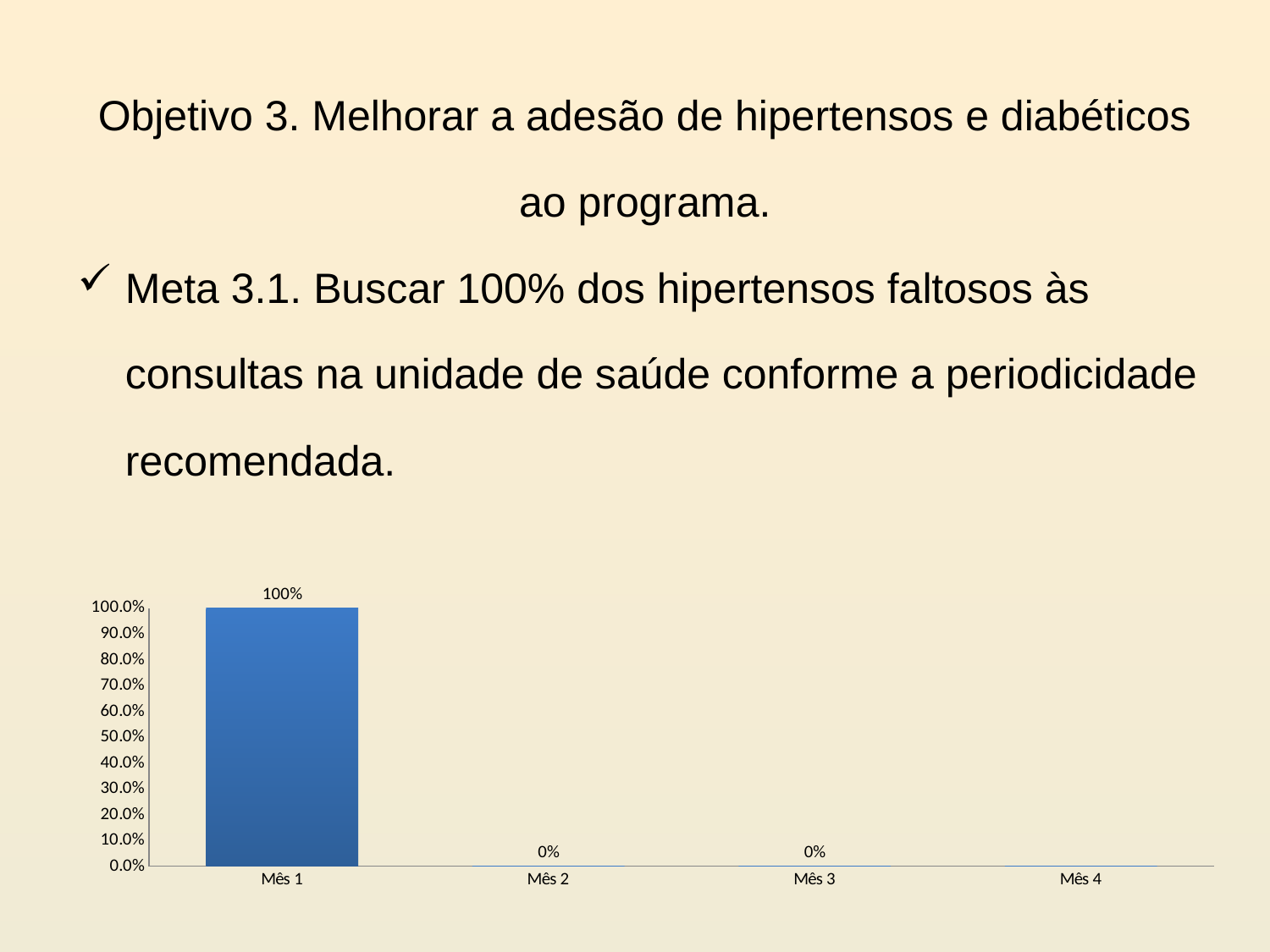
What is the highest tick label on the y axis? 100.0% Is the value for Mês 1 greater or less than 50.0%? greater What is the difference between the values for Mês 1 and Mês 2? 100% How many categories are shown on the x axis? 4 What is the value for Mês 2? 0% What is the value for Mês 3? 0% Which month has the highest value? Mês 1 Do the values rise or fall from Mês 1 to Mês 3? fall Which is larger, the value for Mês 1 or the value for Mês 3? Mês 1 What colour is the bar for Mês 1? Blue What is the value for Mês 1? 100% What kind of chart is shown on the slide? Bar chart